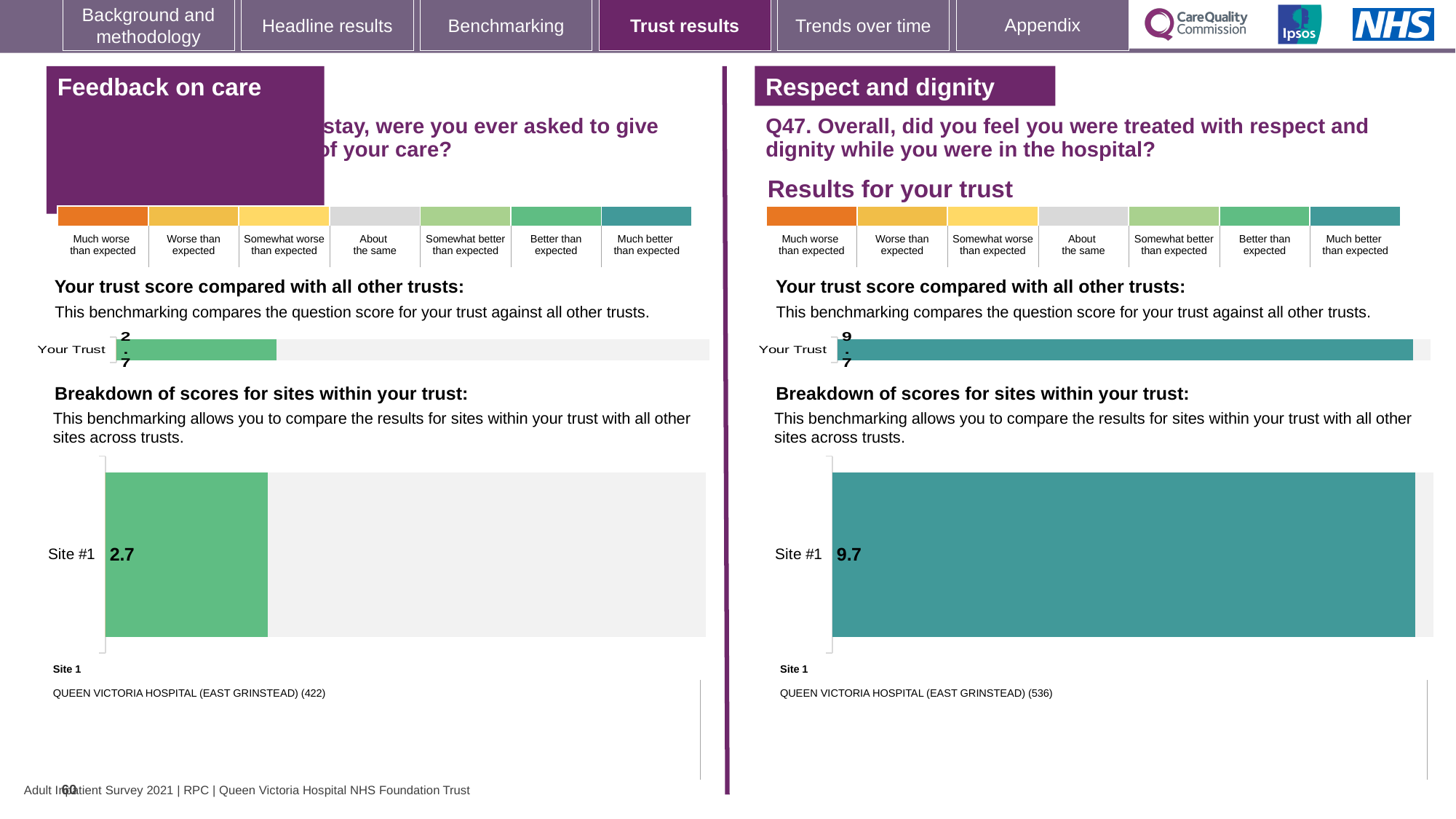
What is the difference between the Site #1 score on the right-hand 'Respect and dignity' panel and the Site #1 score on the left-hand 'Feedback on care' panel? 7.0 Which is larger: the Site #1 score on the left-hand 'Feedback on care' panel or the Site #1 score on the right-hand 'Respect and dignity' panel? Respect and dignity (9.7) What kind of chart is used to show the Site #1 score on the left-hand 'Feedback on care' panel? Bar chart On the left-hand 'Feedback on care' panel, what is the score shown for Your Trust in the 'Your trust score compared with all other trusts' chart? 2.7 Is the Your Trust score on the left-hand 'Feedback on care' panel greater or less than the Your Trust score on the right-hand 'Respect and dignity' panel? less On the left-hand 'Feedback on care' panel, which benchmark category does the colour of the Site #1 bar correspond to in the key? Better than expected Which site is listed as Site 1 beneath the 'Breakdown of scores for sites within your trust' chart on the right-hand 'Respect and dignity' panel? QUEEN VICTORIA HOSPITAL (EAST GRINSTEAD) (536) On the right-hand 'Respect and dignity' panel, what is the score shown for Your Trust in the 'Your trust score compared with all other trusts' chart? 9.7 On the right-hand 'Respect and dignity' panel, which benchmark category does the colour of the Site #1 bar correspond to in the key? Much better than expected On the left-hand 'Feedback on care' panel, what score is shown for Site #1 in the 'Breakdown of scores for sites within your trust' chart? 2.7 On the right-hand 'Respect and dignity' panel, what score is shown for Site #1 in the 'Breakdown of scores for sites within your trust' chart? 9.7 How many sites are shown in the 'Breakdown of scores for sites within your trust' chart on the right-hand 'Respect and dignity' panel? 1